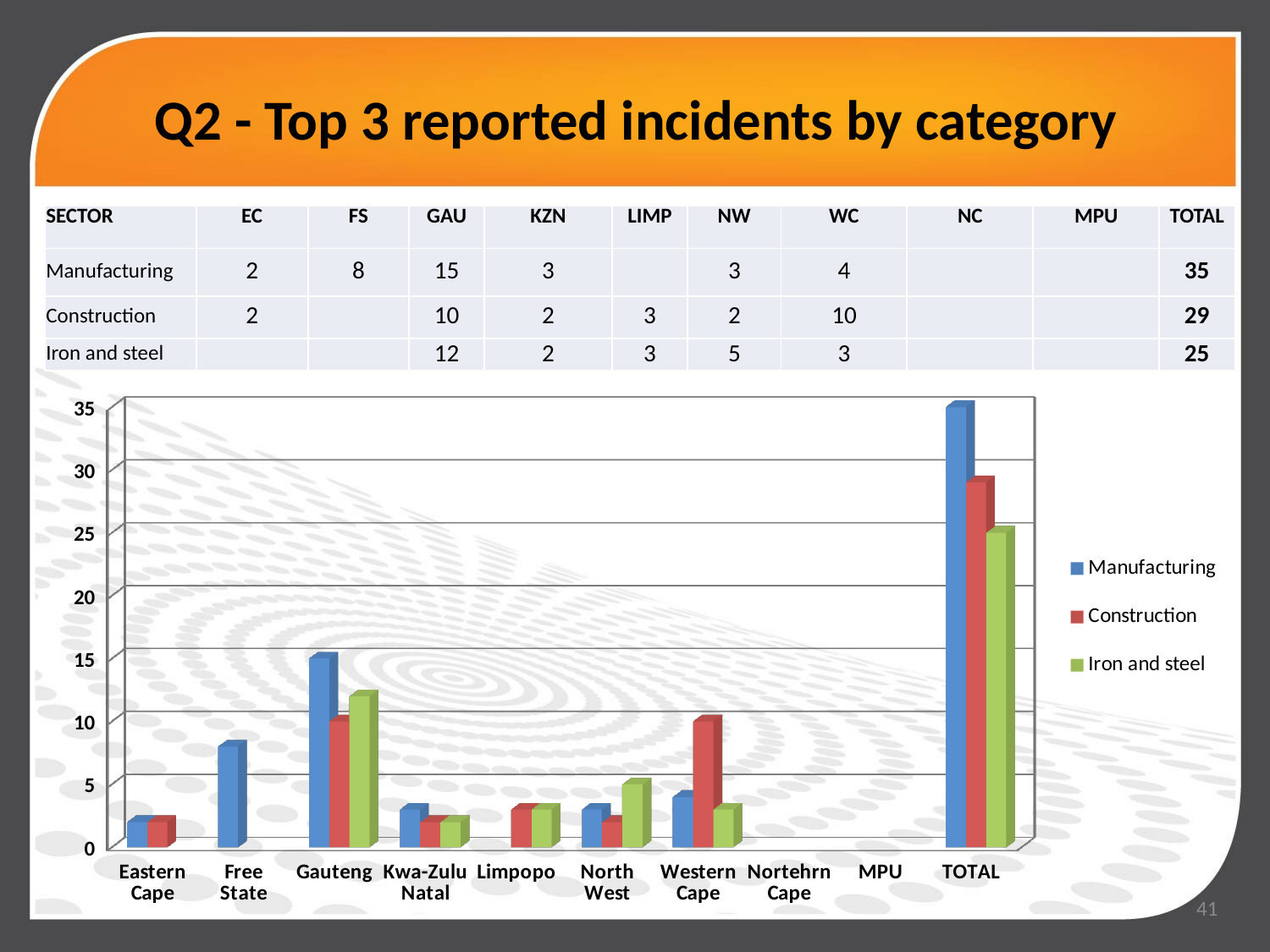
What is the Manufacturing value for Gauteng? 15 What type of chart is shown on the slide? bar chart Which series has the lowest TOTAL value? Iron and steel Which province has the highest Manufacturing value? Gauteng What is the Construction value for Western Cape? 10 What is the Iron and steel value for North West? 5 Which is larger for Gauteng, Construction or Iron and steel? Iron and steel Is the Manufacturing value for Free State greater or less than 5? greater What is the difference between the Manufacturing TOTAL and the Construction TOTAL? 6 Which series is shown in green in the legend? Iron and steel How many series does the chart legend list? 3 What is the TOTAL value for Manufacturing? 35